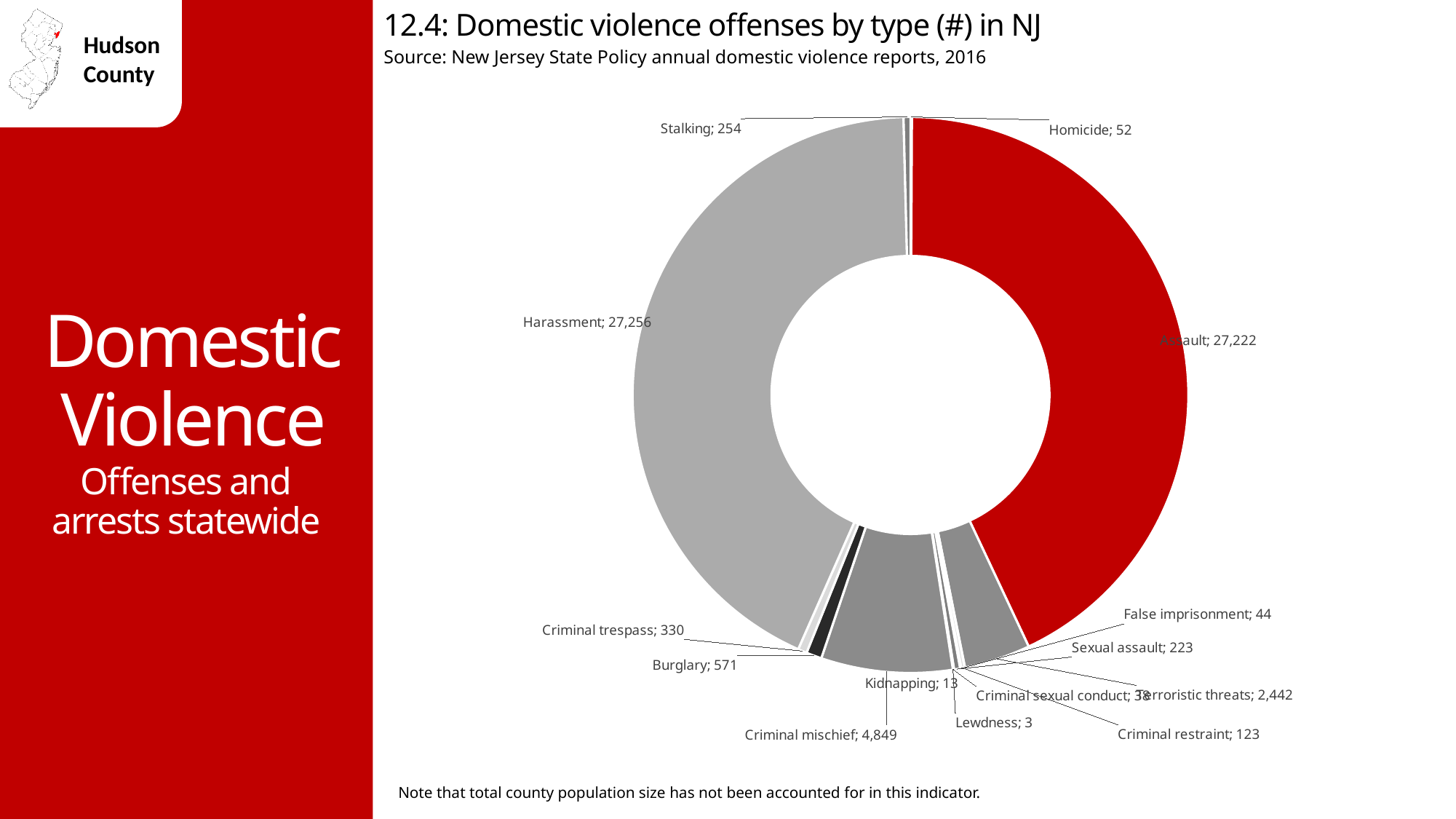
What is the difference between the values for Criminal mischief and Terroristic threats? 2,407 What kind of chart is shown on the slide? doughnut chart What is the difference between the values for Harassment and Assault? 34 How many offense types are shown in the chart? 14 What is the value for Harassment? 27,256 What is the value for Terroristic threats? 2,442 Which offense type has the lowest value? Lewdness What is the value for Homicide? 52 Which offense type has the highest value? Harassment Which is larger, the value for Burglary or the value for Criminal trespass? Burglary What is the value for Assault? 27,222 What is the value for Criminal mischief? 4,849